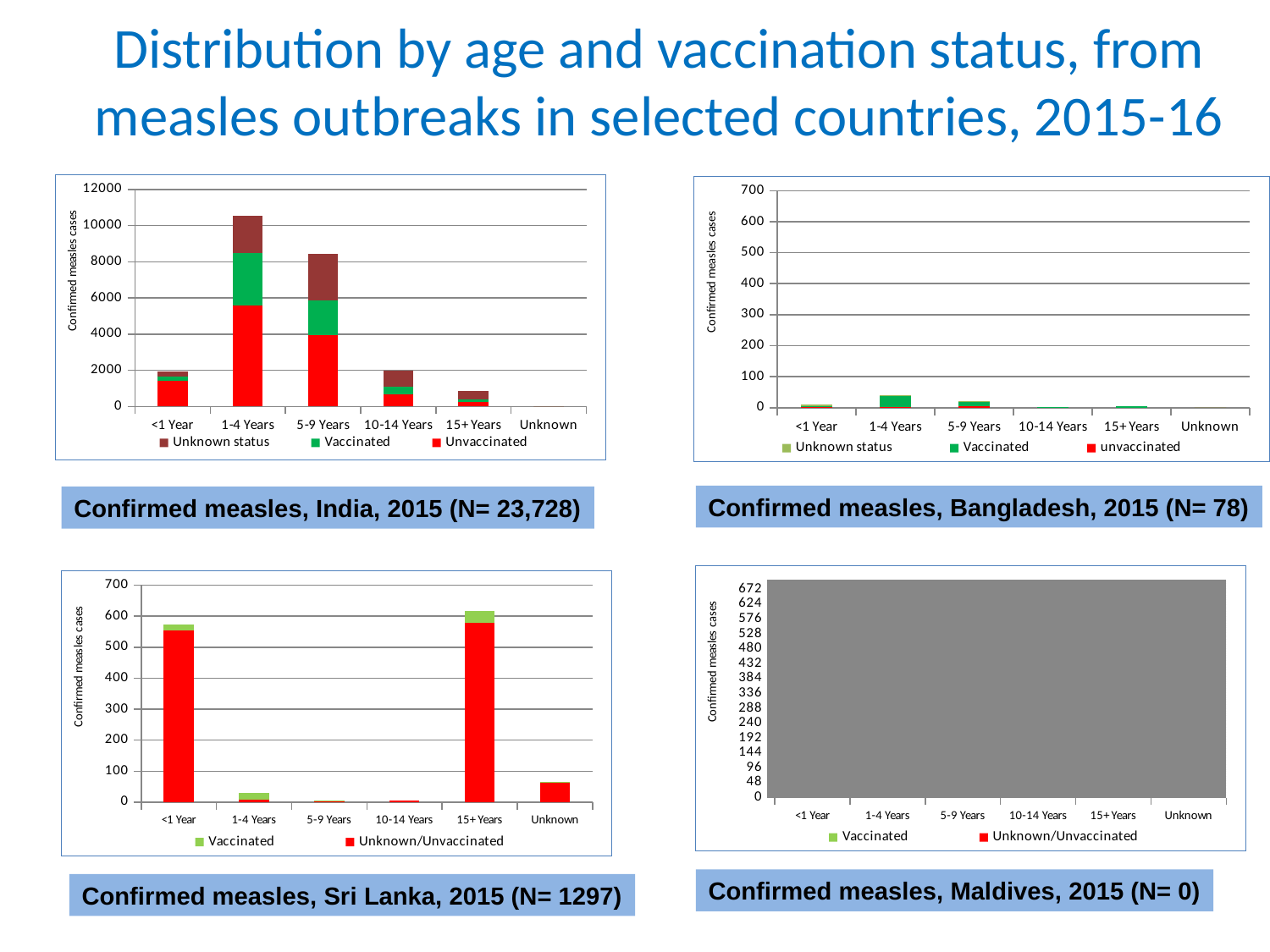
How many series does the legend of the 'Confirmed measles, Maldives, 2015' chart list? 2 In the 'Confirmed measles, Sri Lanka, 2015' chart, which age group has the highest total number of confirmed cases? 15+ Years How many series does the legend of the 'Confirmed measles, India, 2015' chart list? 3 How many age categories are shown on the x axis of the 'Confirmed measles, Sri Lanka, 2015' chart? 6 In the 'Confirmed measles, India, 2015' chart, is the total for 15+ Years greater or less than 2000? less In the 'Confirmed measles, India, 2015' chart, is the total for 1-4 Years greater or less than 8000? greater In the 'Confirmed measles, Bangladesh, 2015' chart, is the value for 1-4 Years greater or less than 100? less What kind of chart is the 'Confirmed measles, India, 2015' chart? bar chart What are the two legend entries in the 'Confirmed measles, Sri Lanka, 2015' chart? Vaccinated and Unknown/Unvaccinated In the 'Confirmed measles, Bangladesh, 2015' chart, which age group has the highest number of confirmed cases? 1-4 Years In the 'Confirmed measles, India, 2015' chart, which age group has the highest total number of confirmed cases? 1-4 Years